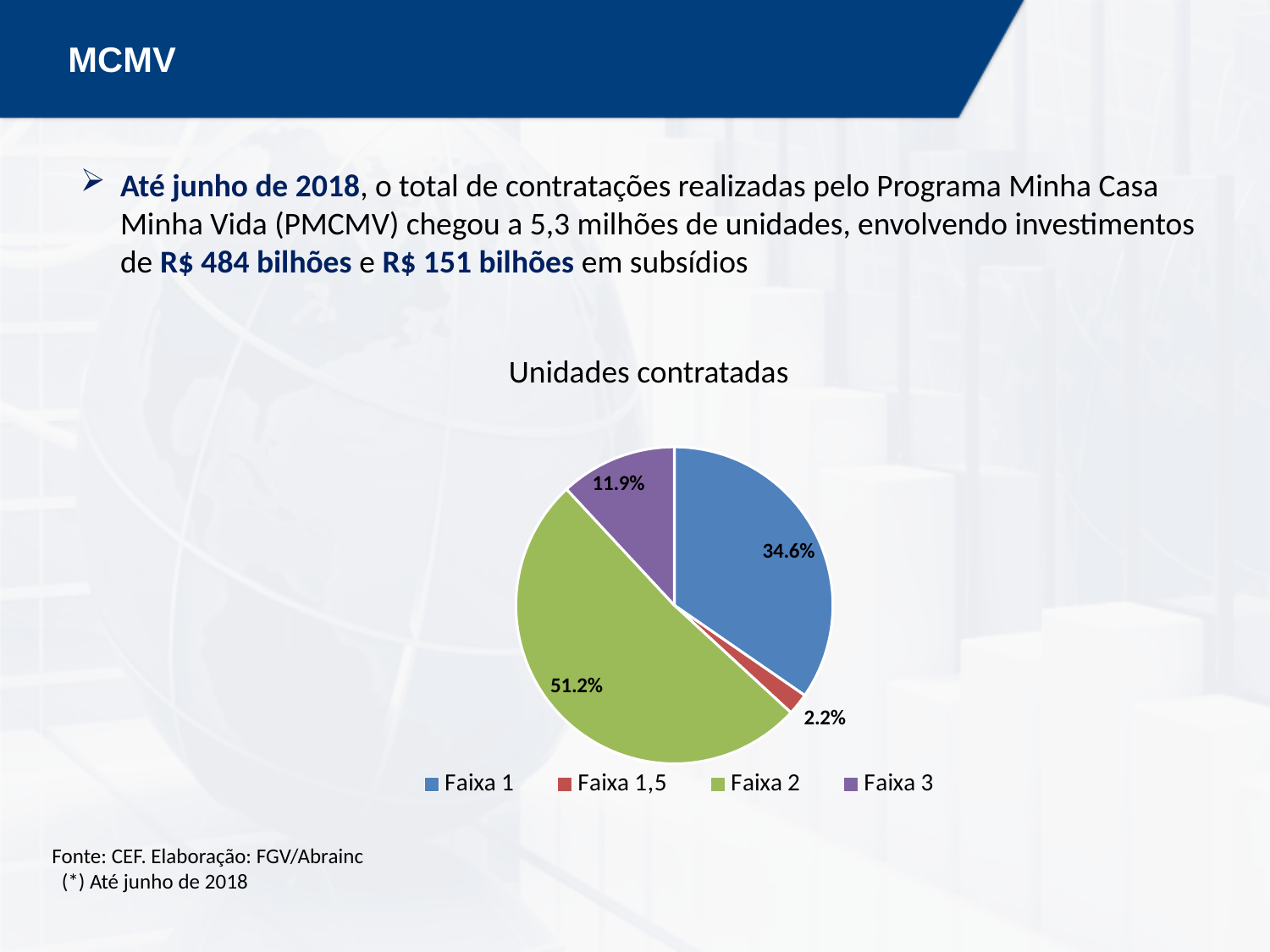
Which category has the smallest slice of the pie? Faixa 1,5 What share of the pie does Faixa 1 represent? 34.6% Which category has the largest slice of the pie? Faixa 2 What share of the pie does Faixa 3 represent? 11.9% What share of the pie does Faixa 2 represent? 51.2% What kind of chart is shown on the slide? Pie chart Which is larger, the share for Faixa 1 or the share for Faixa 3? Faixa 1 What is the title of the chart? Unidades contratadas How many categories does the pie chart show? 4 What is the difference in percentage points between Faixa 2 and Faixa 1? 16.6 What colour is the slice for Faixa 2? Green